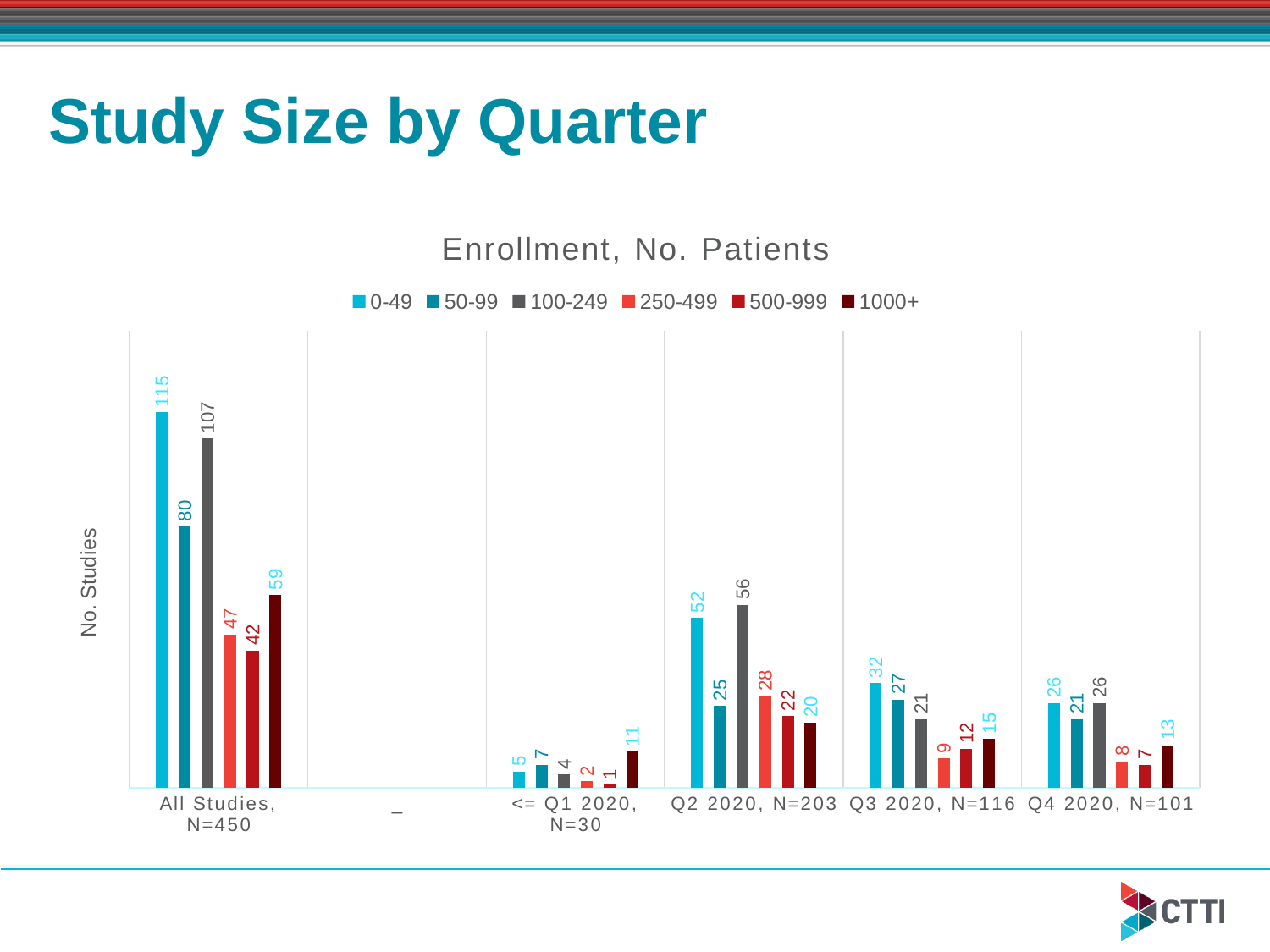
Which series has the highest value in the Q4 2020, N=101 category? 0-49 and 100-249 (both 26) Which is larger in the Q2 2020, N=203 category: the 0-49 value or the 100-249 value? 100-249 Does the 0-49 value rise or fall from Q2 2020 to Q4 2020? Fall What is the title of the chart? Enrollment, No. Patients Which series has the lowest value in the <= Q1 2020, N=30 category? 500-999 What is the value for the 1000+ series in the <= Q1 2020, N=30 category? 11 What is the value for the 500-999 series in the Q3 2020, N=116 category? 12 What is the value for the 100-249 series in the Q2 2020, N=203 category? 56 What kind of chart is shown on the slide? Bar chart What is the value for the 0-49 series in the All Studies, N=450 category? 115 How many series does the legend list? 6 What is the difference between the 0-49 and 50-99 values in the All Studies, N=450 category? 35